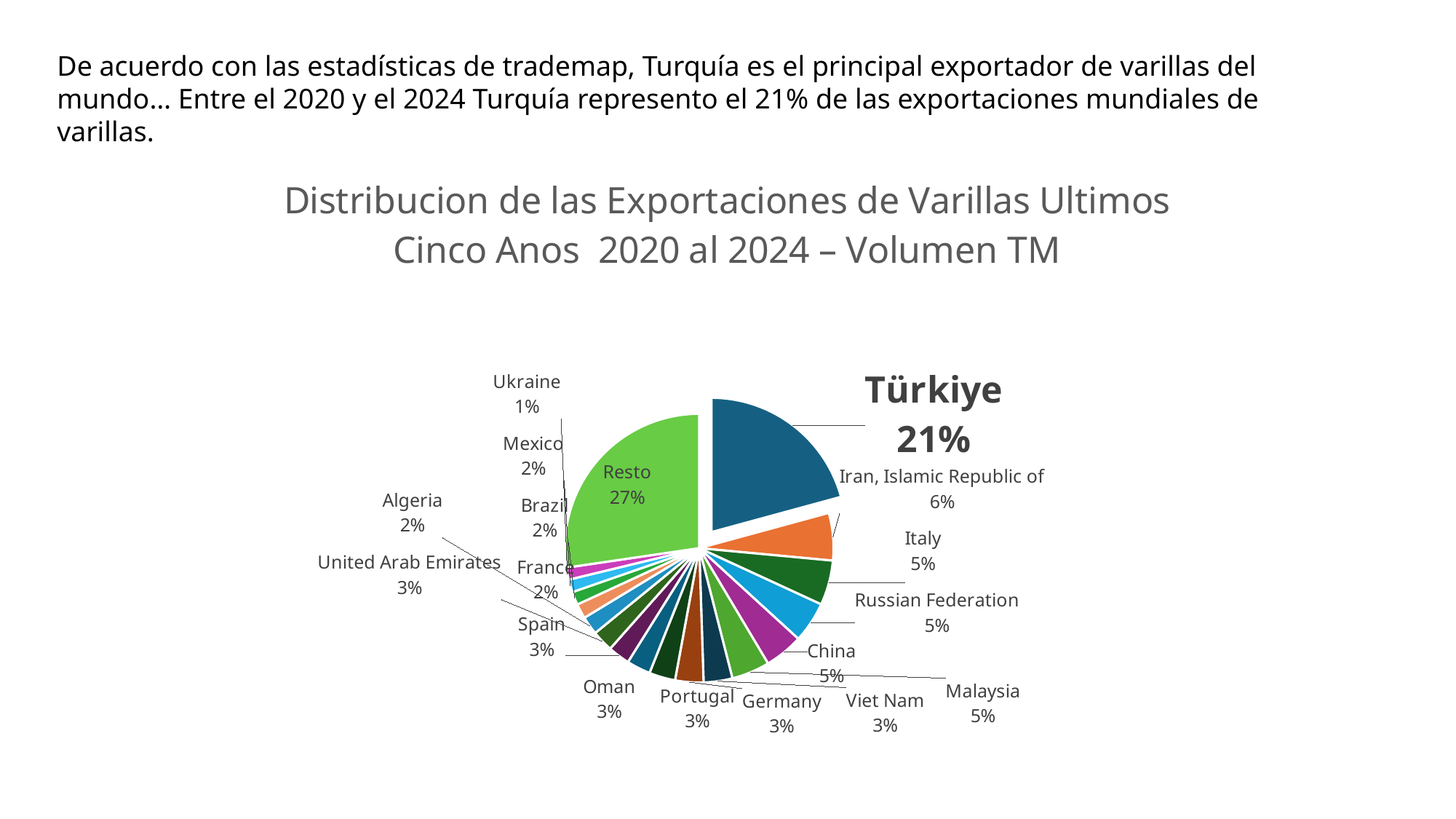
What percentage is shown for Malaysia? 5% What percentage is shown for Ukraine? 1% What percentage is shown for Resto? 27% What is the difference in percentage points between Türkiye and Iran, Islamic Republic of? 15 What kind of chart is shown on the slide? pie chart What share of the pie does Türkiye hold? 21% How many slices does the pie chart have? 18 Which slice of the pie is the largest? Resto Which slice of the pie is the smallest? Ukraine What percentage is shown for Iran, Islamic Republic of? 6% What is the title of the chart? Distribucion de las Exportaciones de Varillas Ultimos Cinco Anos 2020 al 2024 – Volumen TM Which has a larger share, Italy or Viet Nam? Italy